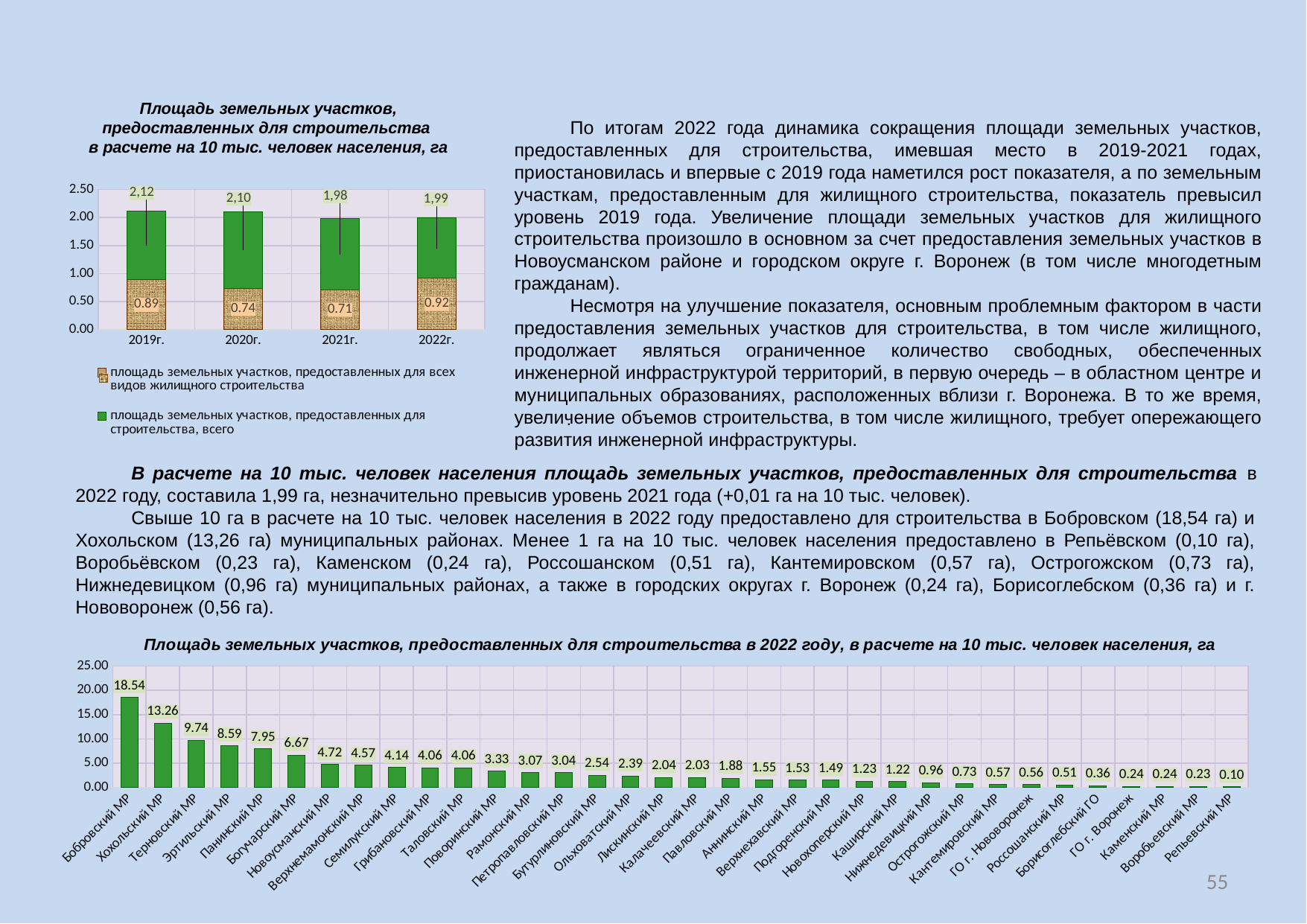
In the bottom chart, which category has the highest value? Бобровский МР In the top-left chart, what is the value for land plots provided for all types of housing construction in 2022? 0.92 How many series does the legend of the top-left chart list? 2 In the top-left chart, which year has the highest value for land plots provided for housing construction? 2022г. In the top-left chart, what is the difference between the housing construction values for 2022 and 2021? 0.21 In the bottom chart, which category has the lowest value? Репьевский МР How many categories are shown in the bottom chart? 34 In the bottom chart, what is the difference between the values for Бобровский МР and Хохольский МР? 5.28 In the bottom chart, which is larger: the value for Панинский МР or Богучарский МР? Панинский МР In the top-left chart, what is the value for total land plots provided for construction in 2019? 2,12 In the top-left chart, which year has the lowest value for total land plots provided for construction? 2021г. In the bottom chart, what is the value for Хохольский МР? 13.26